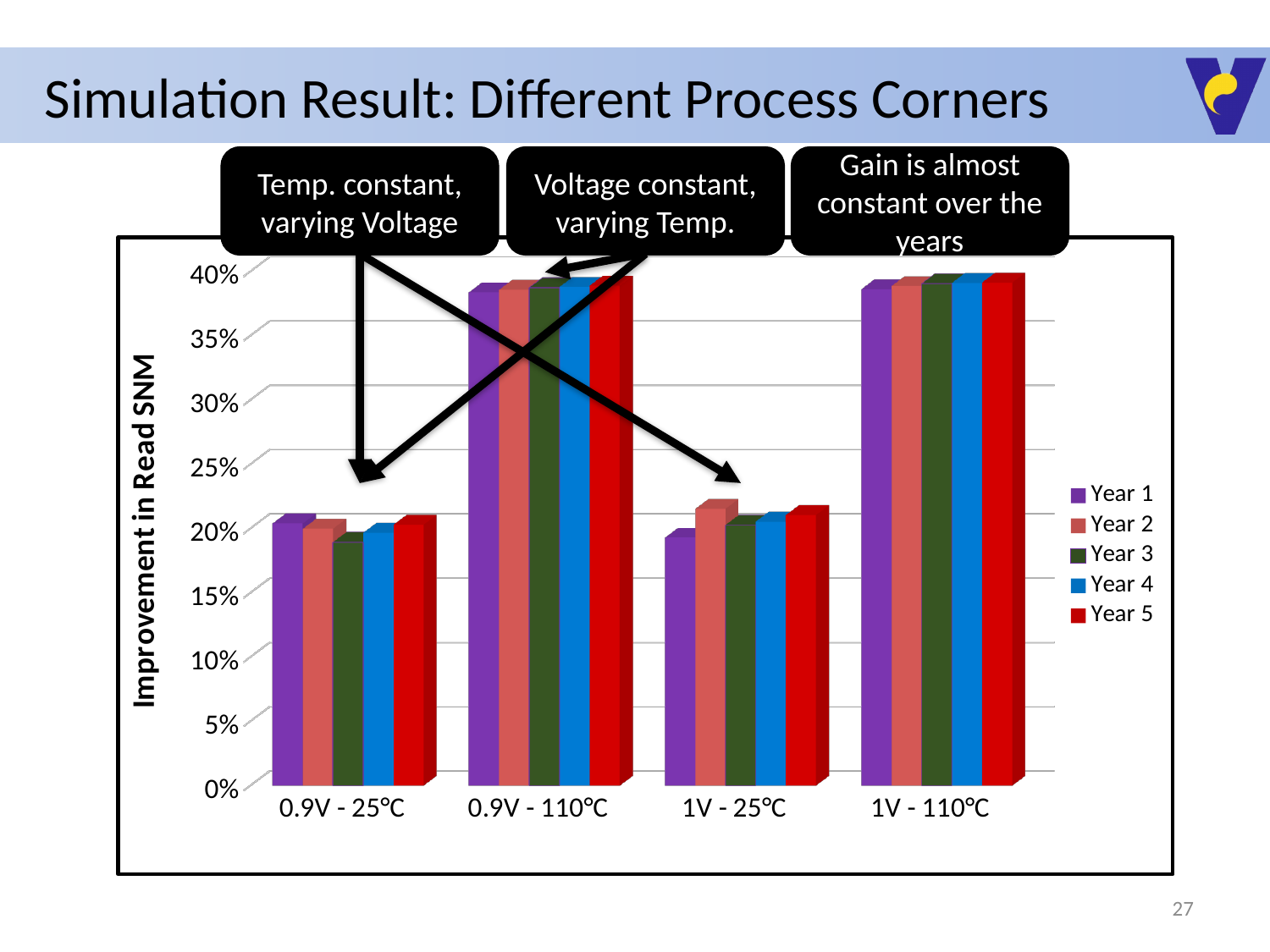
Is the Year 3 value for 0.9V - 25°C greater or less than 15%? greater Is the Year 2 value for 1V - 110°C greater or less than 35%? greater Is the Year 5 value for 1V - 110°C greater or less than 30%? greater For Year 1, which is larger: the value for 0.9V - 25°C or the value for 0.9V - 110°C? 0.9V - 110°C How many series does the chart's legend list? 5 What kind of chart is shown on the slide? bar chart How many categories are shown on the x axis of the chart? 4 For Year 4, which is larger: the value for 1V - 110°C or the value for 1V - 25°C? 1V - 110°C Which series is shown in red in the chart's legend? Year 5 What is the title of the vertical axis of the chart? Improvement in Read SNM